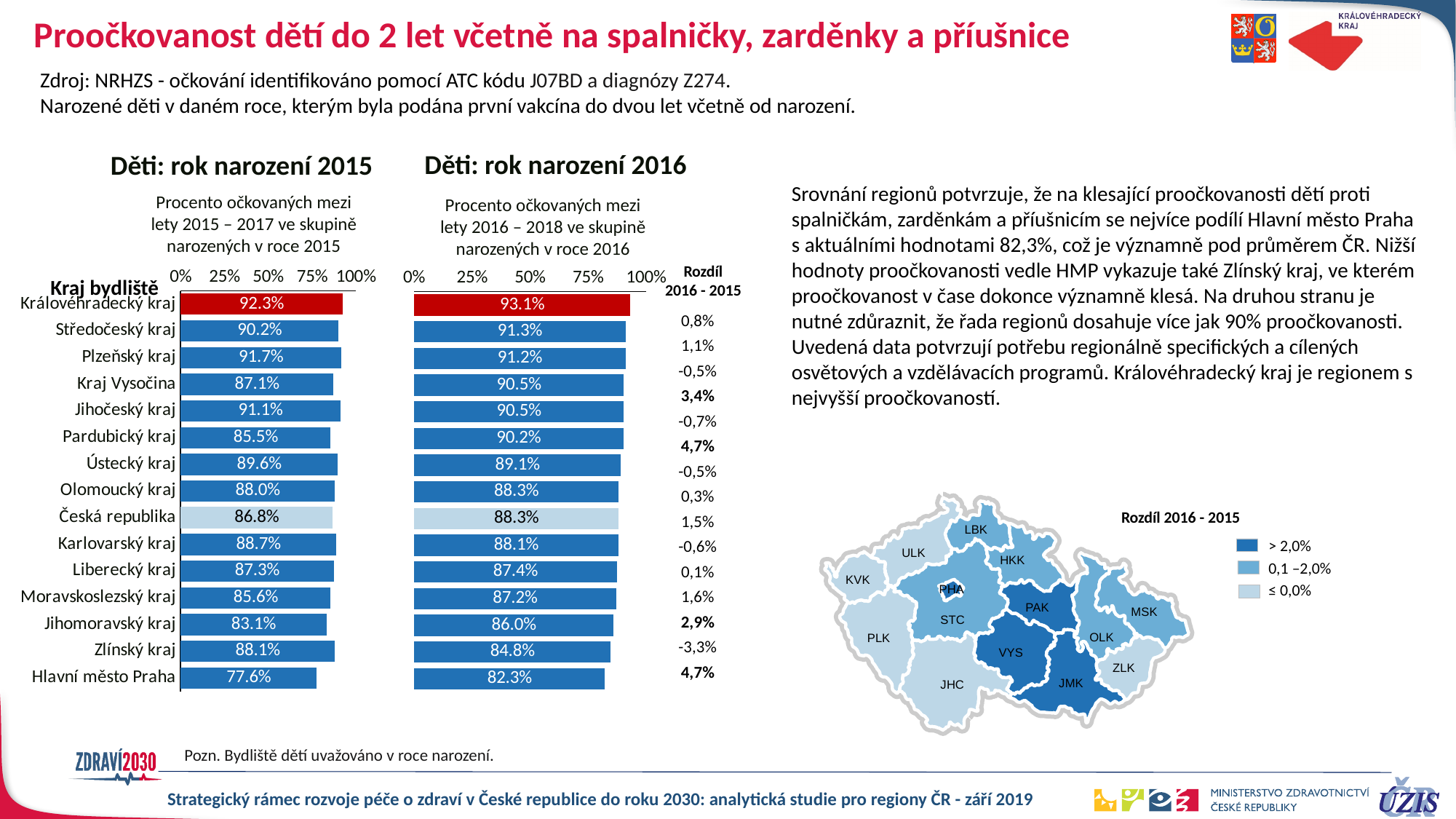
In the chart 'Děti: rok narození 2016', is the value for Pardubický kraj greater or less than 75%? greater In the chart 'Děti: rok narození 2016', which region has the highest value? Královéhradecký kraj In the chart 'Děti: rok narození 2016', what is the difference between Středočeský kraj and Jihomoravský kraj? 5.3% In the chart 'Děti: rok narození 2016', what is the value for Zlínský kraj? 84.8% In the chart 'Děti: rok narození 2015', what is the value for Královéhradecký kraj? 92.3% How many categories (rows) are shown in the chart 'Děti: rok narození 2015'? 15 In the chart 'Děti: rok narození 2015', what is the value for Česká republika? 86.8% In the chart 'Děti: rok narození 2015', which is larger: the value for Plzeňský kraj or the value for Jihočeský kraj? Plzeňský kraj What type of chart is 'Děti: rok narození 2016'? Bar chart In the chart 'Děti: rok narození 2015', which region has the lowest value? Hlavní město Praha In the chart 'Děti: rok narození 2016', what is the value for Hlavní město Praha? 82.3% In the chart 'Děti: rok narození 2015', what is the difference between Královéhradecký kraj and Hlavní město Praha? 14.7%